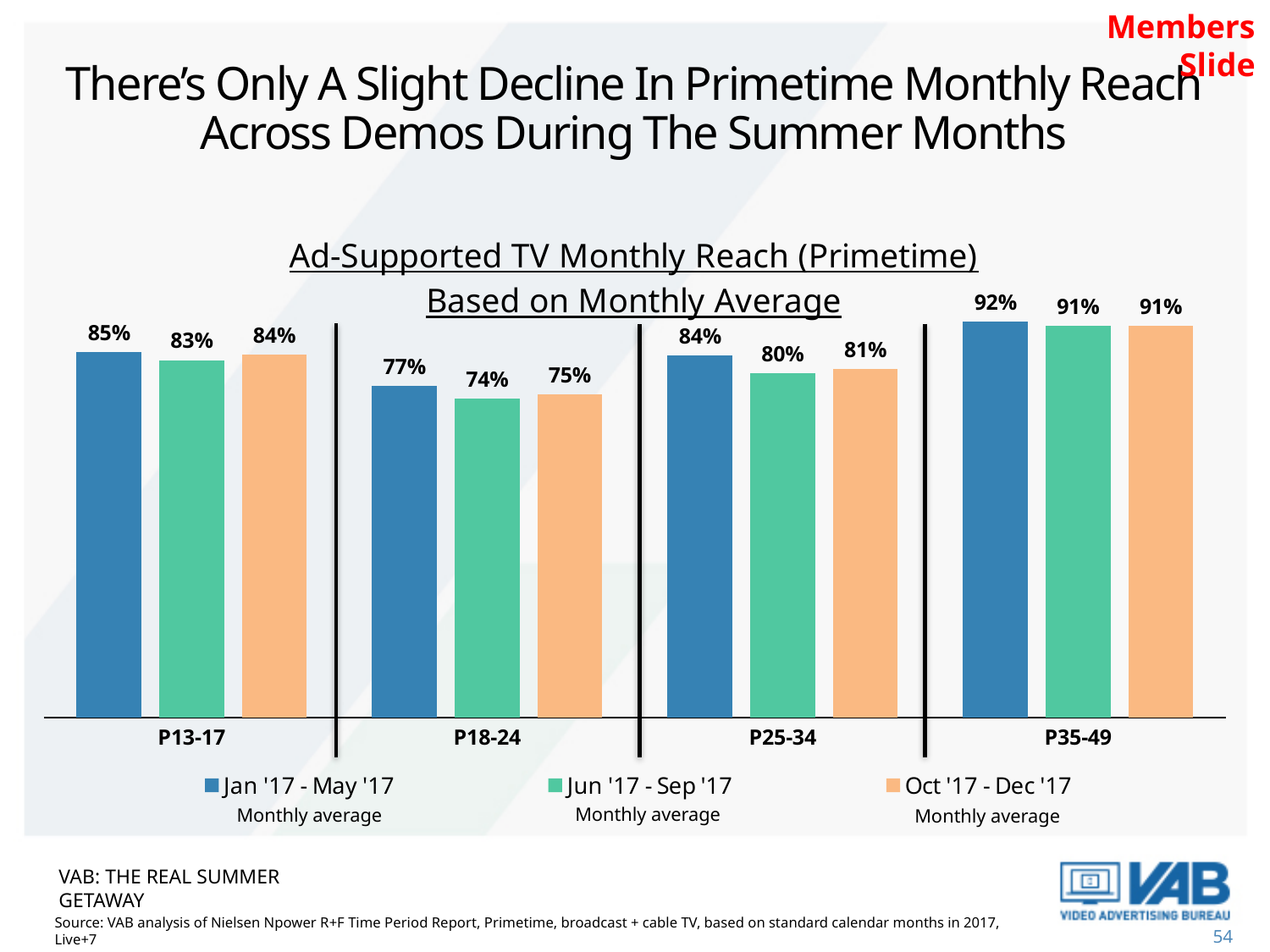
Which demo has the lowest Jun '17 - Sep '17 monthly reach? P18-24 Which demo has the highest Jan '17 - May '17 monthly reach? P35-49 How many demo groups are shown on the x axis? 4 How many series does the legend list? 3 What is the Jun '17 - Sep '17 monthly reach value for P18-24? 74% Which is larger for P13-17: the Jun '17 - Sep '17 value or the Oct '17 - Dec '17 value? Oct '17 - Dec '17 What is the title of the chart? Ad-Supported TV Monthly Reach (Primetime) Based on Monthly Average What is the difference between the Jan '17 - May '17 and Jun '17 - Sep '17 values for P25-34? 4% What is the Jan '17 - May '17 monthly reach value for P35-49? 92% What kind of chart is shown on the slide? Bar chart What is the Jan '17 - May '17 monthly reach value for P13-17? 85% What is the Oct '17 - Dec '17 monthly reach value for P25-34? 81%